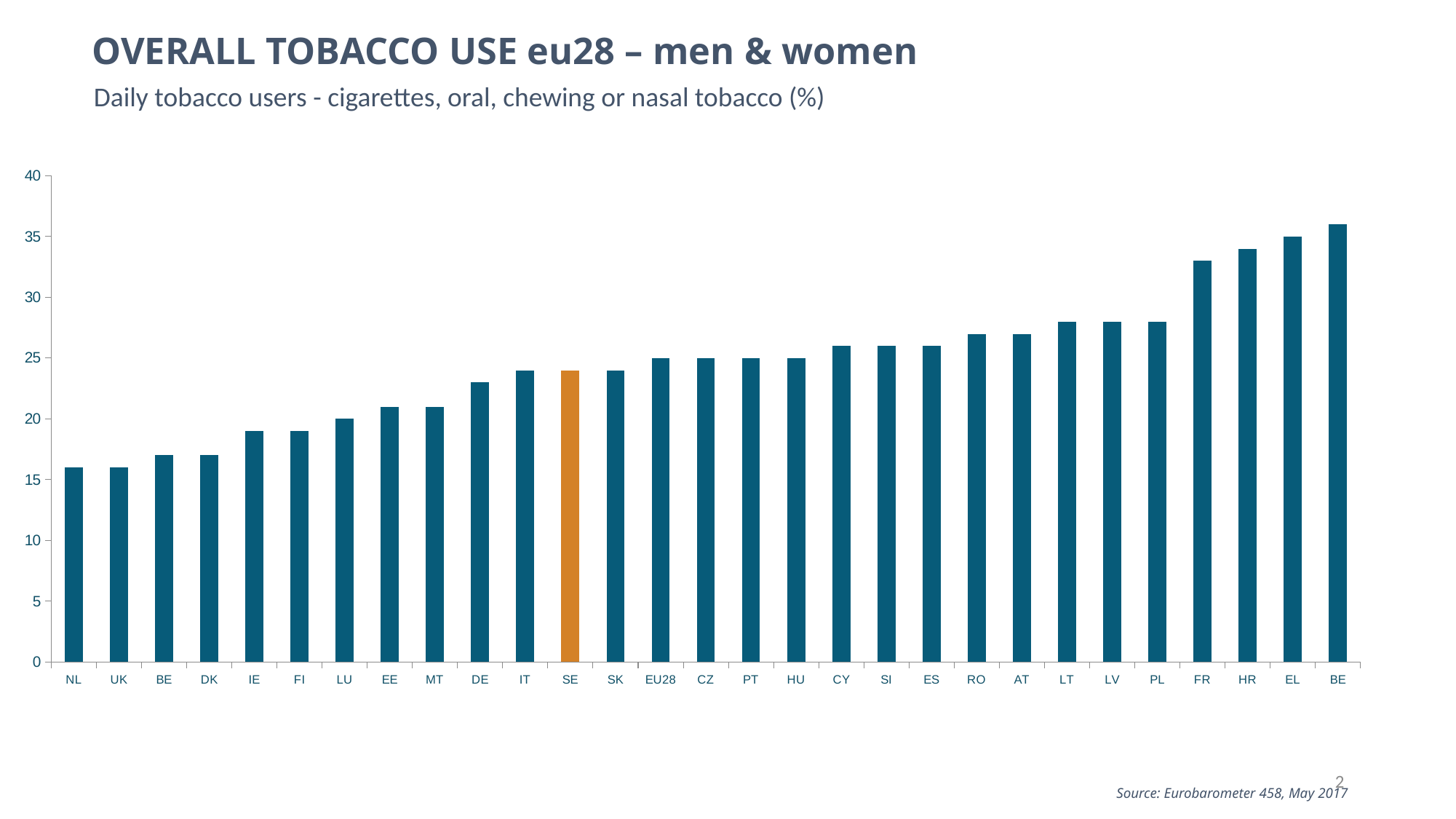
Which has the larger value, DE or HR? HR Is the value for NL greater or less than 20? less What is the title of the chart on the slide? OVERALL TOBACCO USE eu28 – men & women Which has the larger value, IE or CY? CY Which category has the highest value on the chart? BE (rightmost) Do the values generally rise or fall from left to right along the x axis? rise Which bar is highlighted in orange on the chart? SE Is the value for FR greater or less than 30? greater What kind of chart is shown on the slide? bar chart Is the value for SE greater or less than 25? less How many bars are plotted on the chart? 29